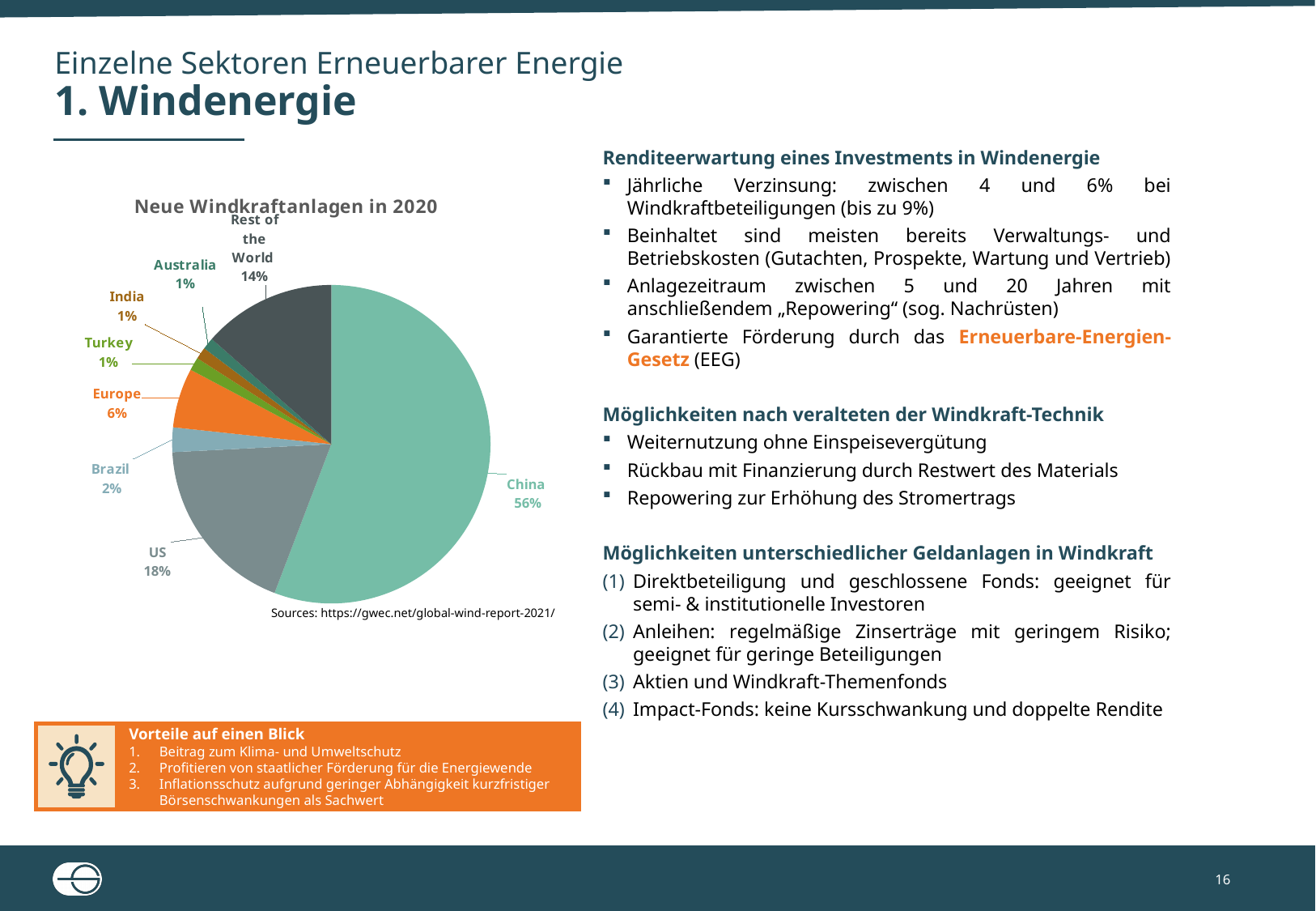
Which category has the largest slice of the pie? China What is the difference between the shares of China and the US? 38% What share of the pie does Europe have? 6% What share of the pie does China have? 56% How many categories are shown in the pie chart? 8 What share of the pie does Brazil have? 2% What is the difference between the shares of the US and Rest of the World? 4% Which is larger, the share for Europe or the share for Brazil? Europe What is the title of the chart? Neue Windkraftanlagen in 2020 What type of chart is shown on the slide? pie chart What share of the pie does Rest of the World have? 14% What share of the pie does the US have? 18%